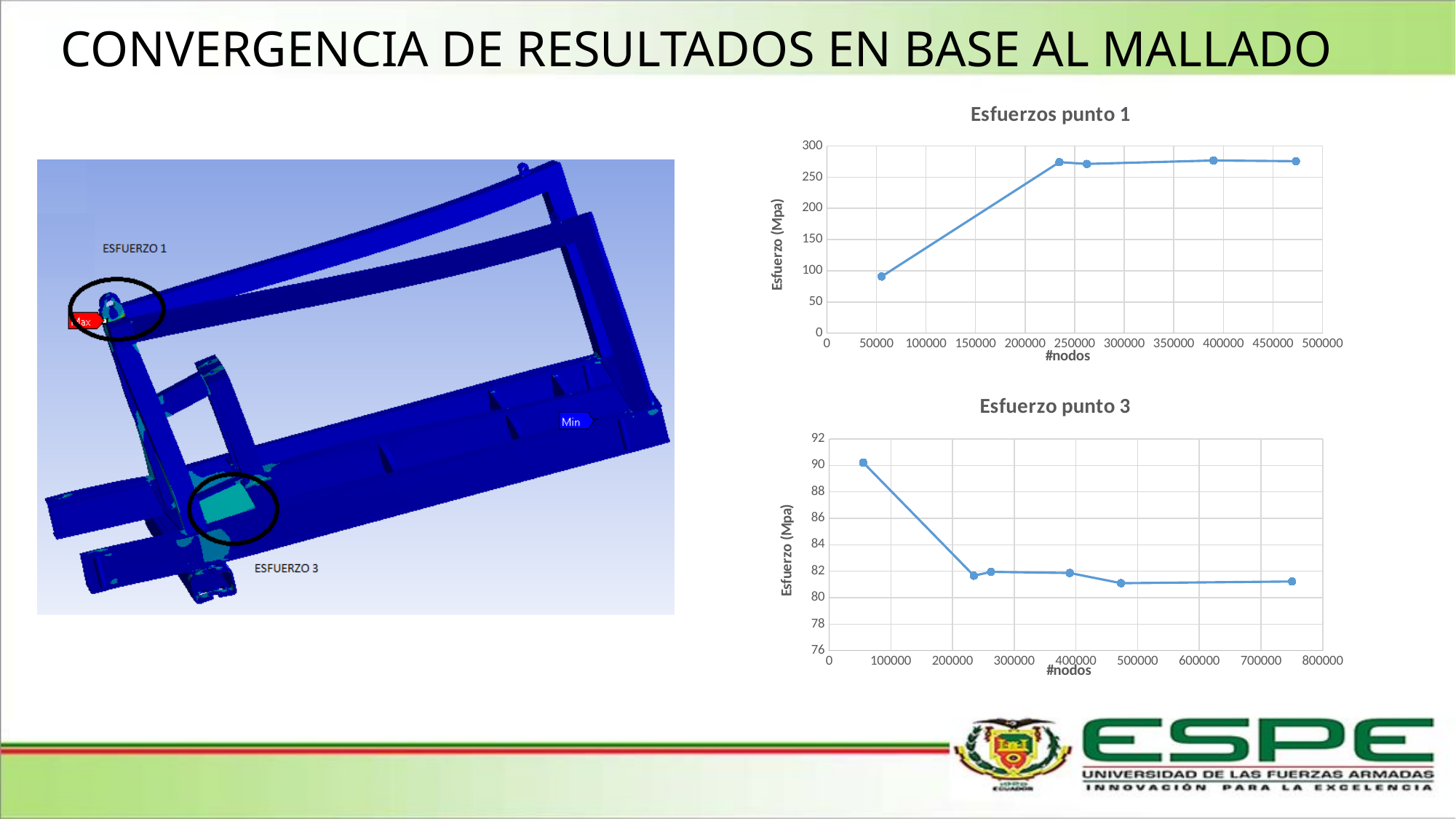
In the "Esfuerzo punto 3" chart, which point has the highest stress value? the first point (around 50000 nodes) How many data points are plotted in the "Esfuerzo punto 3" chart? 6 What kind of chart is "Esfuerzo punto 3"? line chart In the "Esfuerzo punto 3" chart, is the value at the last point (around 750000 nodes) greater or less than 82? less What kind of chart is "Esfuerzos punto 1"? line chart What is the y-axis title of the "Esfuerzos punto 1" chart? Esfuerzo (Mpa) In the "Esfuerzo punto 3" chart, does the stress rise or fall between the first and second points? fall In the "Esfuerzo punto 3" chart, is the value at the first point (around 50000 nodes) greater or less than 88? greater In the "Esfuerzos punto 1" chart, does the stress rise or fall between the first and second points? rise In the "Esfuerzos punto 1" chart, is the value at the first point (around 50000 nodes) greater or less than 100? less How many data points are plotted in the "Esfuerzos punto 1" chart? 5